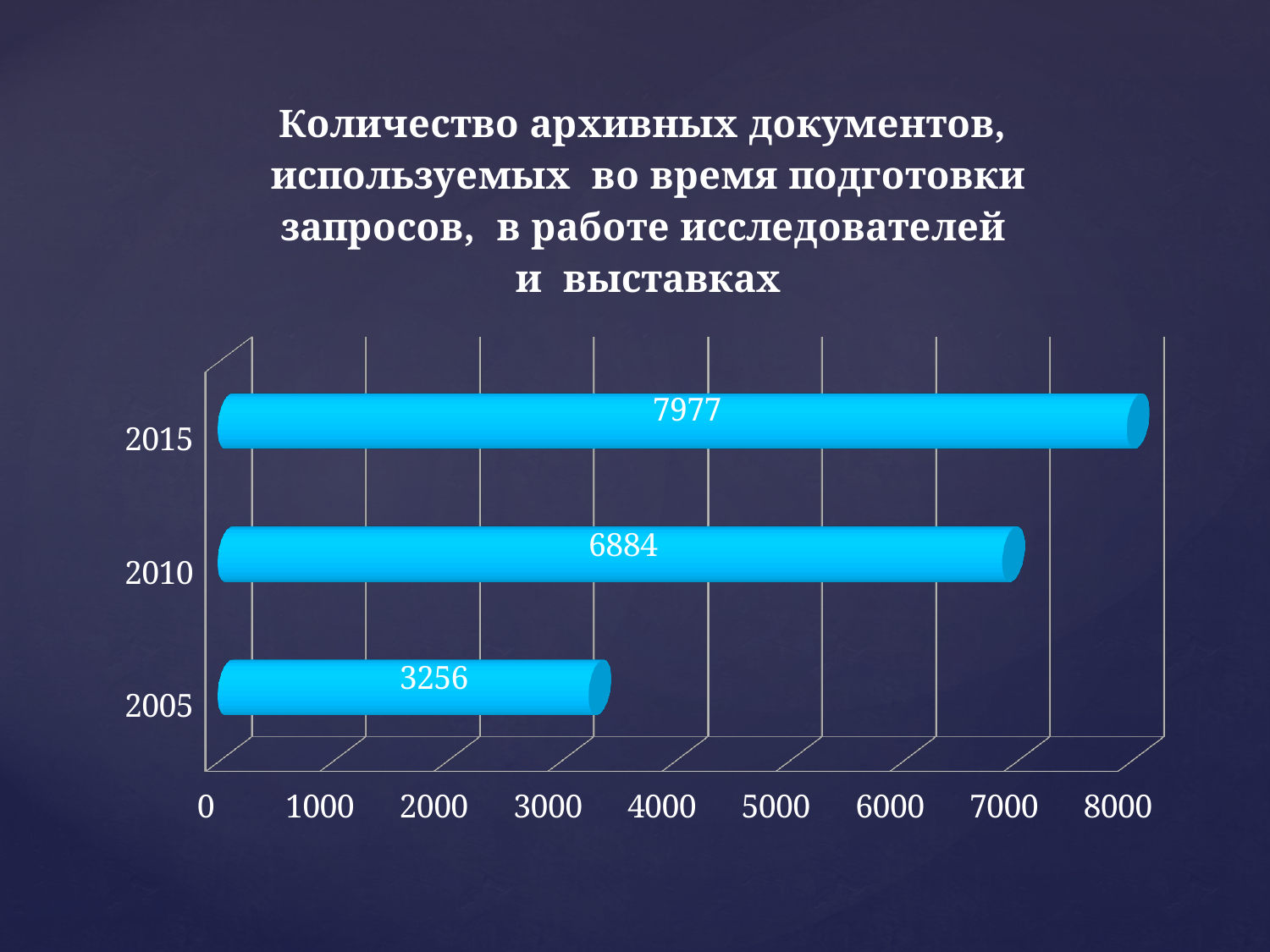
Which is larger, the value for 2010 or the value for 2005? 2010 Which year has the lowest value? 2005 What is the value for 2010? 6884 What is the difference between the values for 2015 and 2005? 4721 How many years are shown in the chart? 3 What is the difference between the values for 2015 and 2010? 1093 Do the values rise or fall from 2005 to 2015? rise What is the value for 2015? 7977 What kind of chart is shown on the slide? bar chart What is the value for 2005? 3256 Which year has the highest value? 2015 Is the value for 2010 greater or less than 6000? greater